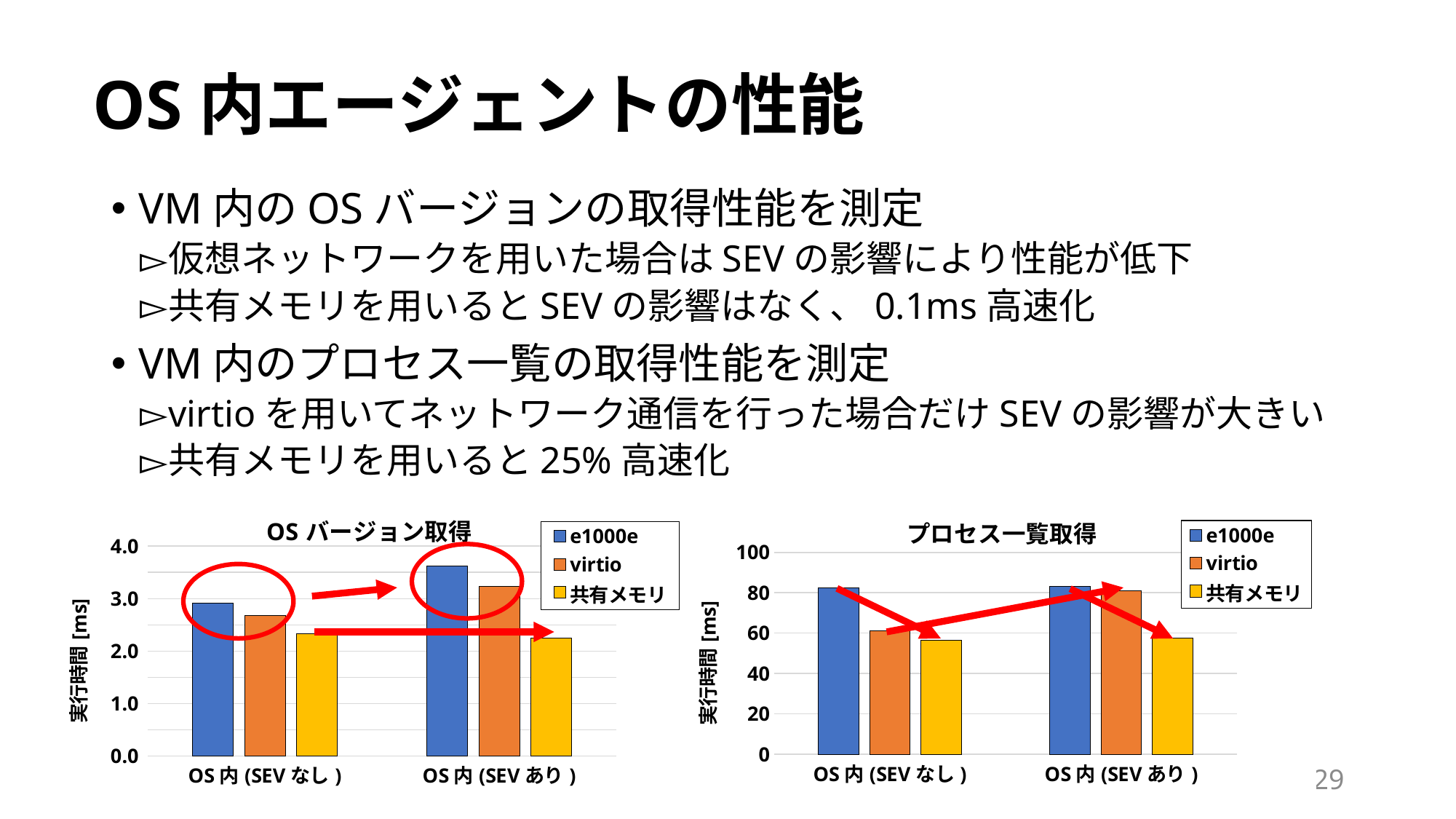
In the "OS バージョン取得" chart, is the value for virtio at OS 内 (SEV なし) greater or less than 3.0? less In the "プロセス一覧取得" chart, is the value for 共有メモリ at OS 内 (SEV あり) greater or less than 60? less In the "OS バージョン取得" chart, is the value for e1000e at OS 内 (SEV あり) greater or less than 3.0? greater What is the y-axis label of the "プロセス一覧取得" chart? 実行時間 [ms] How many series does the legend of the "プロセス一覧取得" chart list? 3 What type of chart is the "OS バージョン取得" chart on the left? bar chart In the "OS バージョン取得" chart, which is larger at OS 内 (SEV なし): e1000e or virtio? e1000e In the "OS バージョン取得" chart, does the e1000e value rise or fall from OS 内 (SEV なし) to OS 内 (SEV あり)? rise In the "OS バージョン取得" chart, which bar is the highest? e1000e, OS 内 (SEV あり) How many categories are shown on the x axis of the "OS バージョン取得" chart? 2